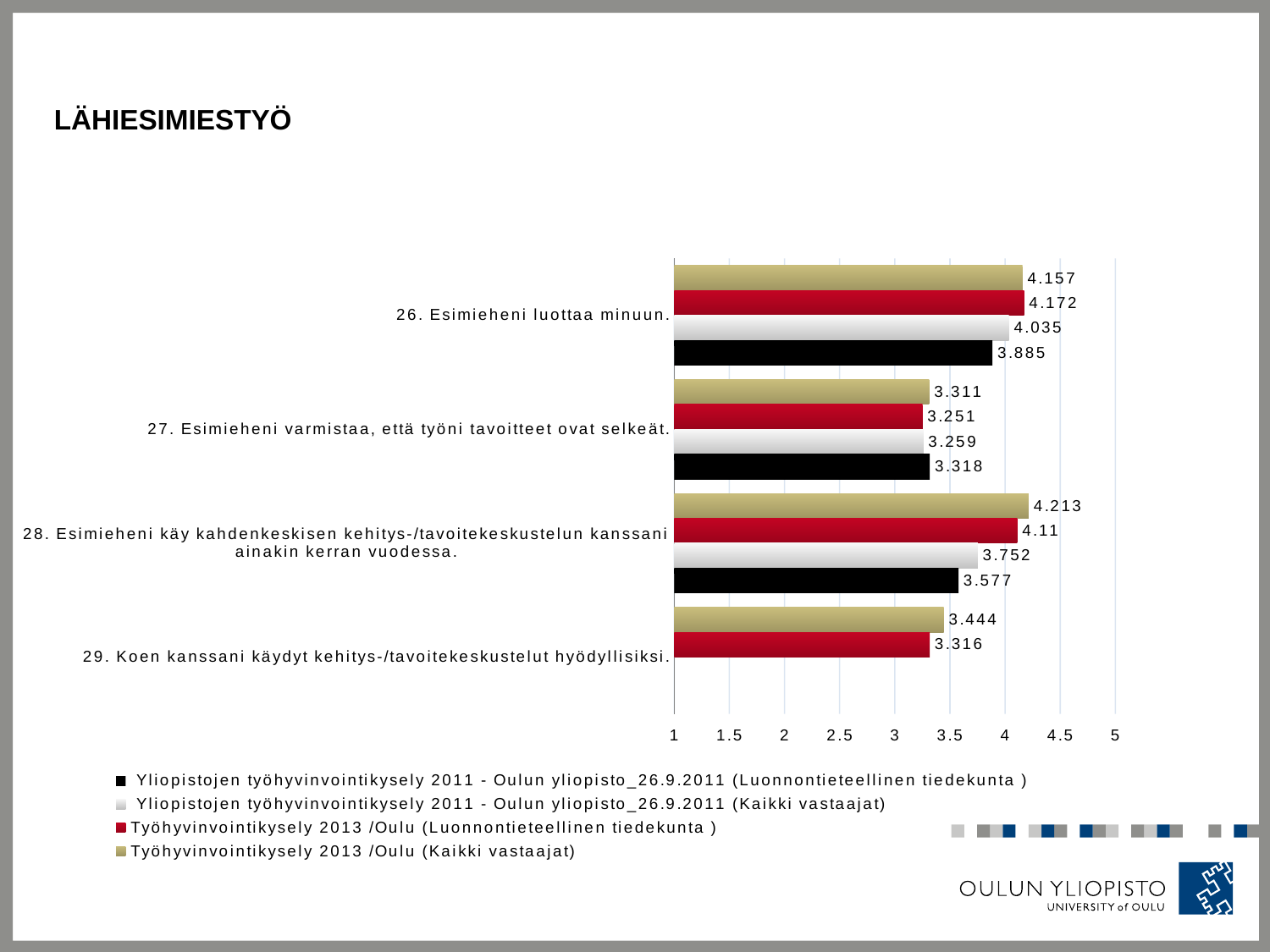
What is the value for '29. Koen kanssani käydyt kehitys-/tavoitekeskustelut hyödyllisiksi.' in the Työhyvinvointikysely 2013 /Oulu (Luonnontieteellinen tiedekunta) series? 3.316 For statement 26, which is larger: the Työhyvinvointikysely 2013 /Oulu (Luonnontieteellinen tiedekunta) value or the Yliopistojen työhyvinvointikysely 2011 (Kaikki vastaajat) value? Työhyvinvointikysely 2013 /Oulu (Luonnontieteellinen tiedekunta) What kind of chart is shown on the slide? bar chart What is the value for '28. Esimieheni käy kahdenkeskisen kehitys-/tavoitekeskustelun kanssani ainakin kerran vuodessa.' in the Yliopistojen työhyvinvointikysely 2011 (Luonnontieteellinen tiedekunta) series? 3.577 Which statement has the lowest value in the Yliopistojen työhyvinvointikysely 2011 (Kaikki vastaajat) series? 27. Esimieheni varmistaa, että työni tavoitteet ovat selkeät. Which statement has the highest value in the Työhyvinvointikysely 2013 /Oulu (Kaikki vastaajat) series? 28. Esimieheni käy kahdenkeskisen kehitys-/tavoitekeskustelun kanssani ainakin kerran vuodessa. What is the title of the slide? LÄHIESIMIESTYÖ What is the value for '26. Esimieheni luottaa minuun.' in the Työhyvinvointikysely 2013 /Oulu (Kaikki vastaajat) series? 4.157 How many series does the legend list? 4 How many categories (statements) are shown on the y axis? 4 Is the value for statement 27 in the Työhyvinvointikysely 2013 /Oulu (Kaikki vastaajat) series greater or less than 3.5? less What is the difference between the Työhyvinvointikysely 2013 /Oulu (Kaikki vastaajat) value and the Yliopistojen työhyvinvointikysely 2011 (Luonnontieteellinen tiedekunta) value for statement 28? 0.636